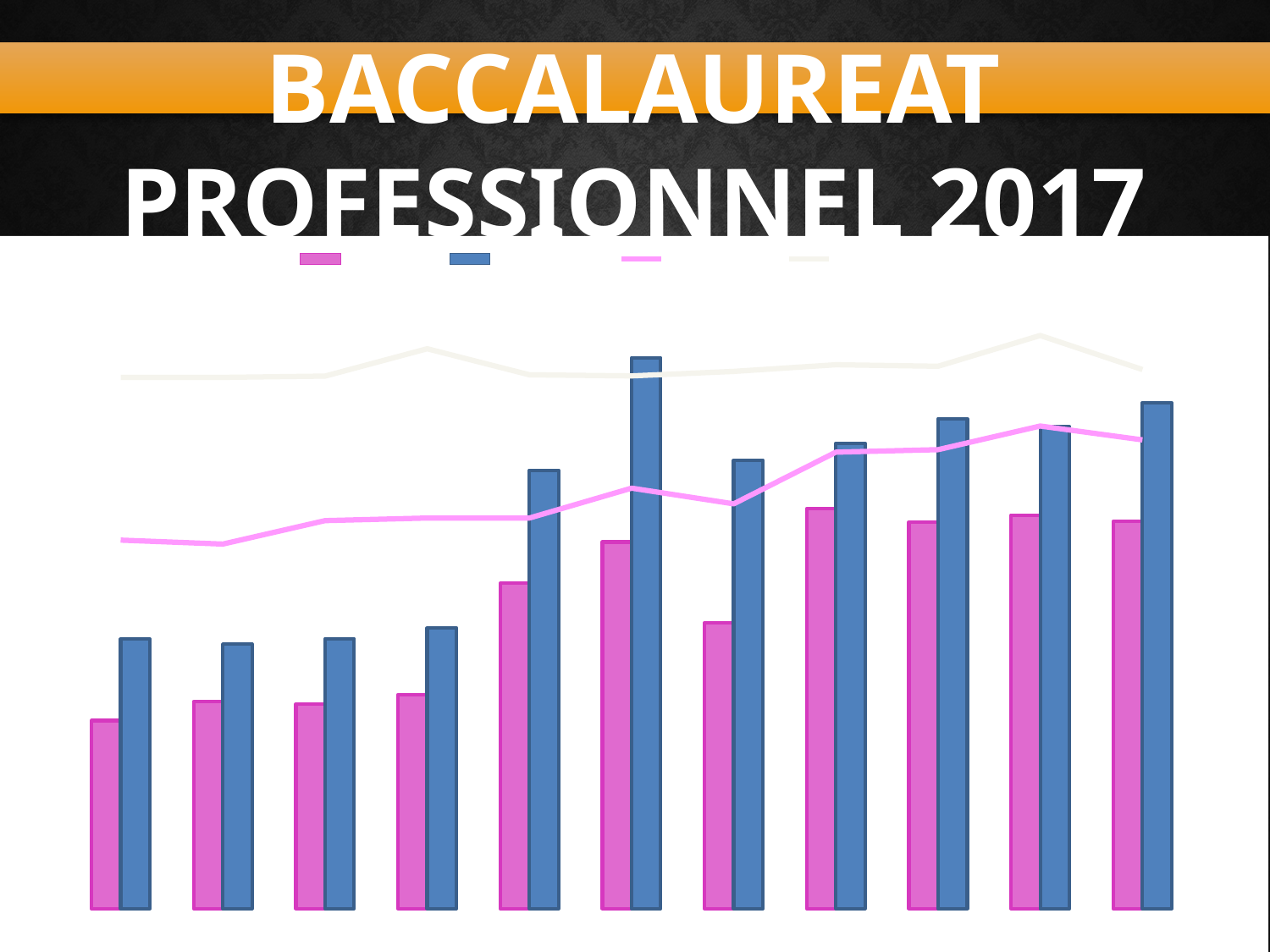
Do the blue bars generally rise or fall from left to right along the x axis? rise What two colours are used for the bars in the chart? pink and blue How many series does the legend list? 4 What is the title shown above the chart? BACCALAUREAT PROFESSIONNEL 2017 Do the pink bars generally rise or fall from left to right along the x axis? rise In each group, is the blue bar taller or shorter than the pink bar? taller What kind of chart is shown on the slide? combination bar and line chart How many groups of bars are plotted along the x axis? 11